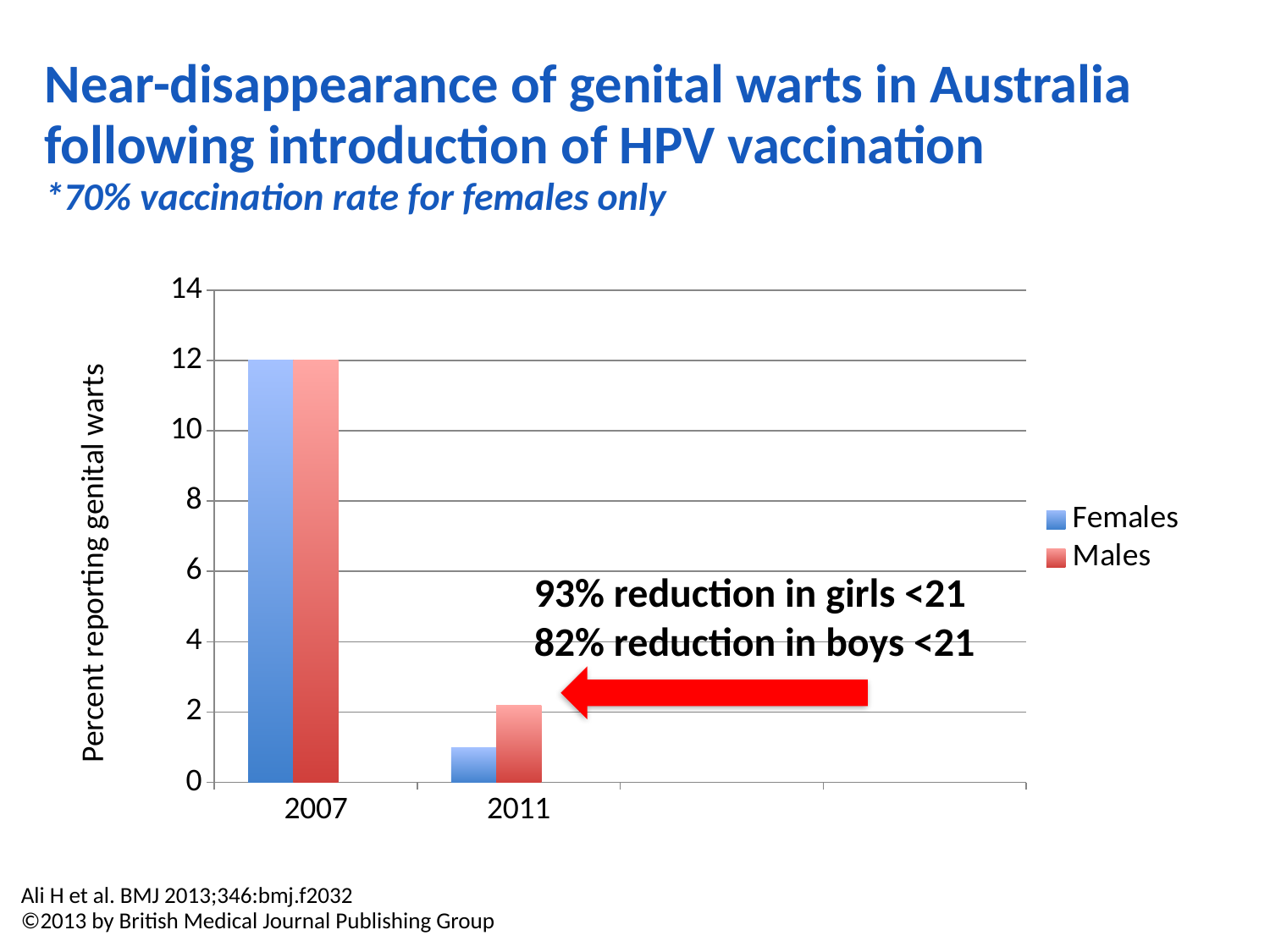
How many years (categories) are plotted on the x axis? 2 What is the value for Females in 2007? 12 Is the value for Males in 2011 greater or less than 4? less What is the label on the y axis? Percent reporting genital warts What kind of chart is shown on the slide? bar chart Do the values for Females rise or fall from 2007 to 2011? fall In which year is the Males value highest? 2007 What is the value for Males in 2007? 12 In 2011, which series has the larger value, Females or Males? Males Which series is shown in red in the legend? Males How many series does the legend list? 2 Is the value for Females in 2011 greater or less than 2? less